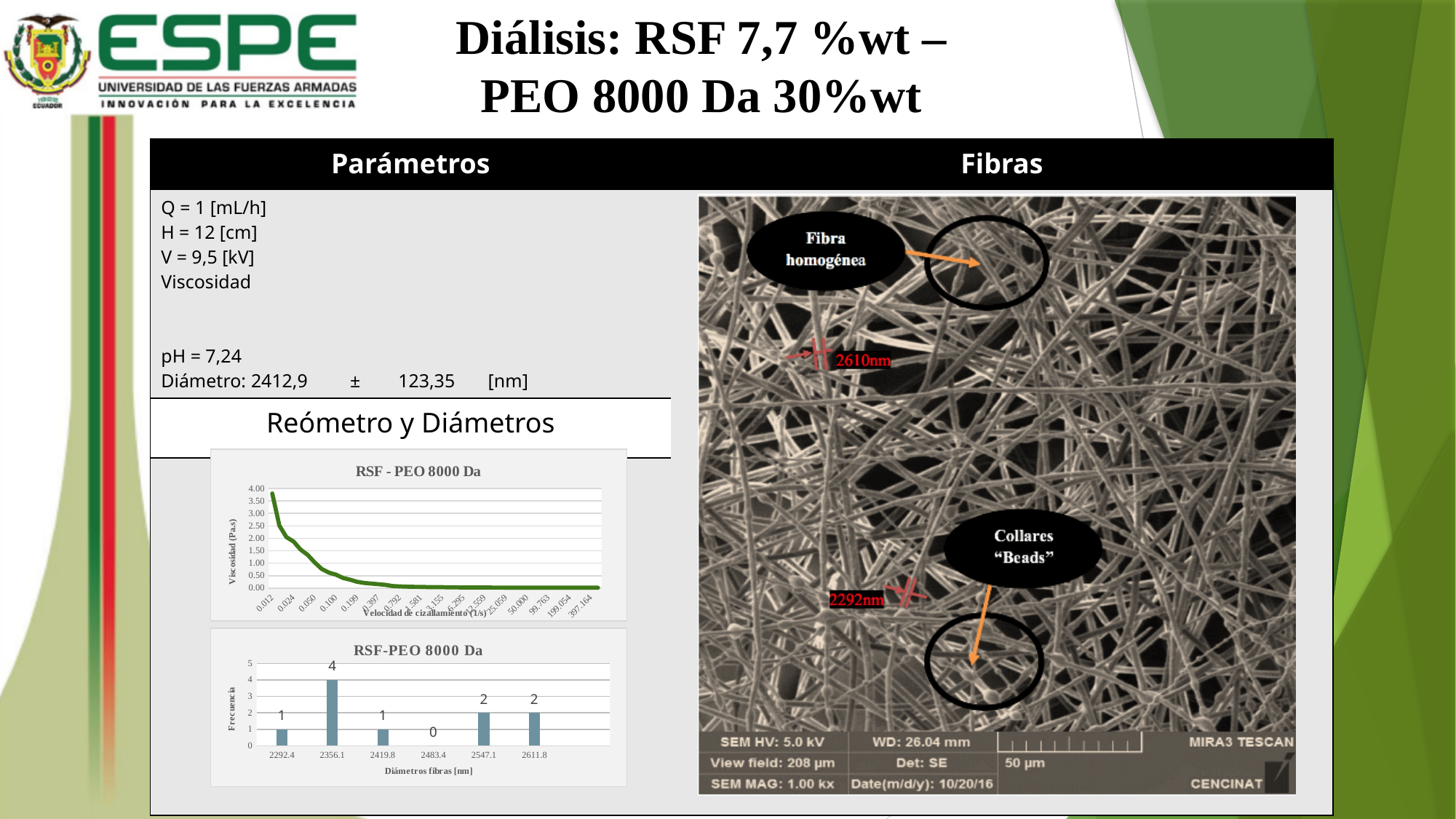
In the top chart titled "RSF - PEO 8000 Da", does the viscosity rise or fall as the shear rate increases along the x axis? fall In the top chart titled "RSF - PEO 8000 Da", is the viscosity at the first point (0.012) greater or less than 3.00? greater In the bottom chart titled "RSF-PEO 8000 Da", which diameter category has the lowest frequency? 2483.4 In the bottom chart titled "RSF-PEO 8000 Da", which diameter category has the highest frequency? 2356.1 In the bottom chart titled "RSF-PEO 8000 Da", what is the frequency for the diameter 2483.4? 0 In the bottom chart titled "RSF-PEO 8000 Da", which has the larger frequency, 2292.4 or 2547.1? 2547.1 What kind of chart is the bottom chart titled "RSF-PEO 8000 Da"? bar chart In the bottom chart titled "RSF-PEO 8000 Da", what is the frequency for the diameter 2611.8? 2 In the bottom chart titled "RSF-PEO 8000 Da", what is the difference between the frequency for 2356.1 and the frequency for 2547.1? 2 What kind of chart is the top chart titled "RSF - PEO 8000 Da"? line chart How many diameter categories are shown on the x axis of the bottom chart titled "RSF-PEO 8000 Da"? 6 In the bottom chart titled "RSF-PEO 8000 Da", what is the frequency for the diameter 2356.1? 4